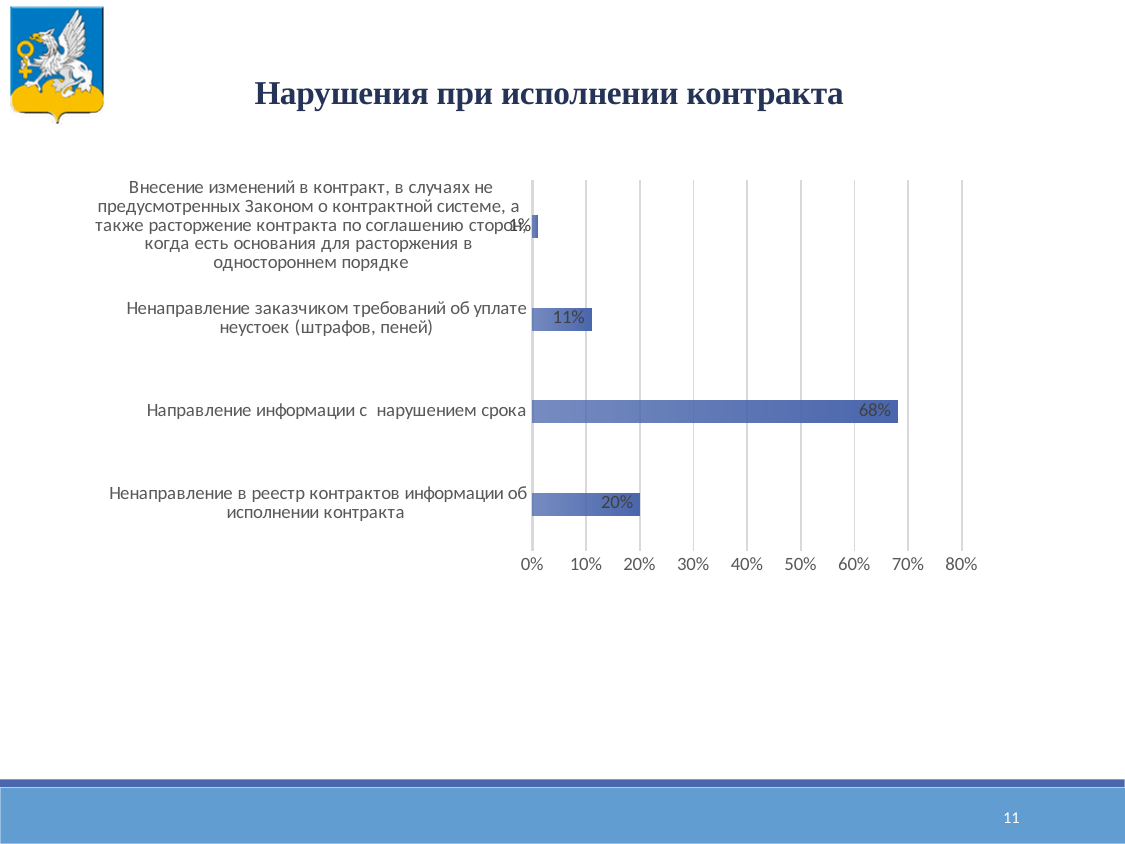
Which category has the highest value? Направление информации с нарушением срока What is the value for "Направление информации с нарушением срока"? 68% What is the value for "Ненаправление в реестр контрактов информации об исполнении контракта"? 20% Which is larger: the value for "Ненаправление заказчиком требований об уплате неустоек (штрафов, пеней)" or the value for "Ненаправление в реестр контрактов информации об исполнении контракта"? Ненаправление в реестр контрактов информации об исполнении контракта What is the title of the slide? Нарушения при исполнении контракта What kind of chart is shown on the slide? bar chart What is the value for "Ненаправление заказчиком требований об уплате неустоек (штрафов, пеней)"? 11% What is the value for the category about making changes to the contract in cases not provided for by the Law on the contract system ("Внесение изменений в контракт...")? 1% Is the value for "Направление информации с нарушением срока" greater or less than 50%? greater How many categories are shown in the chart? 4 What is the difference between the values for "Направление информации с нарушением срока" and "Ненаправление в реестр контрактов информации об исполнении контракта"? 48%